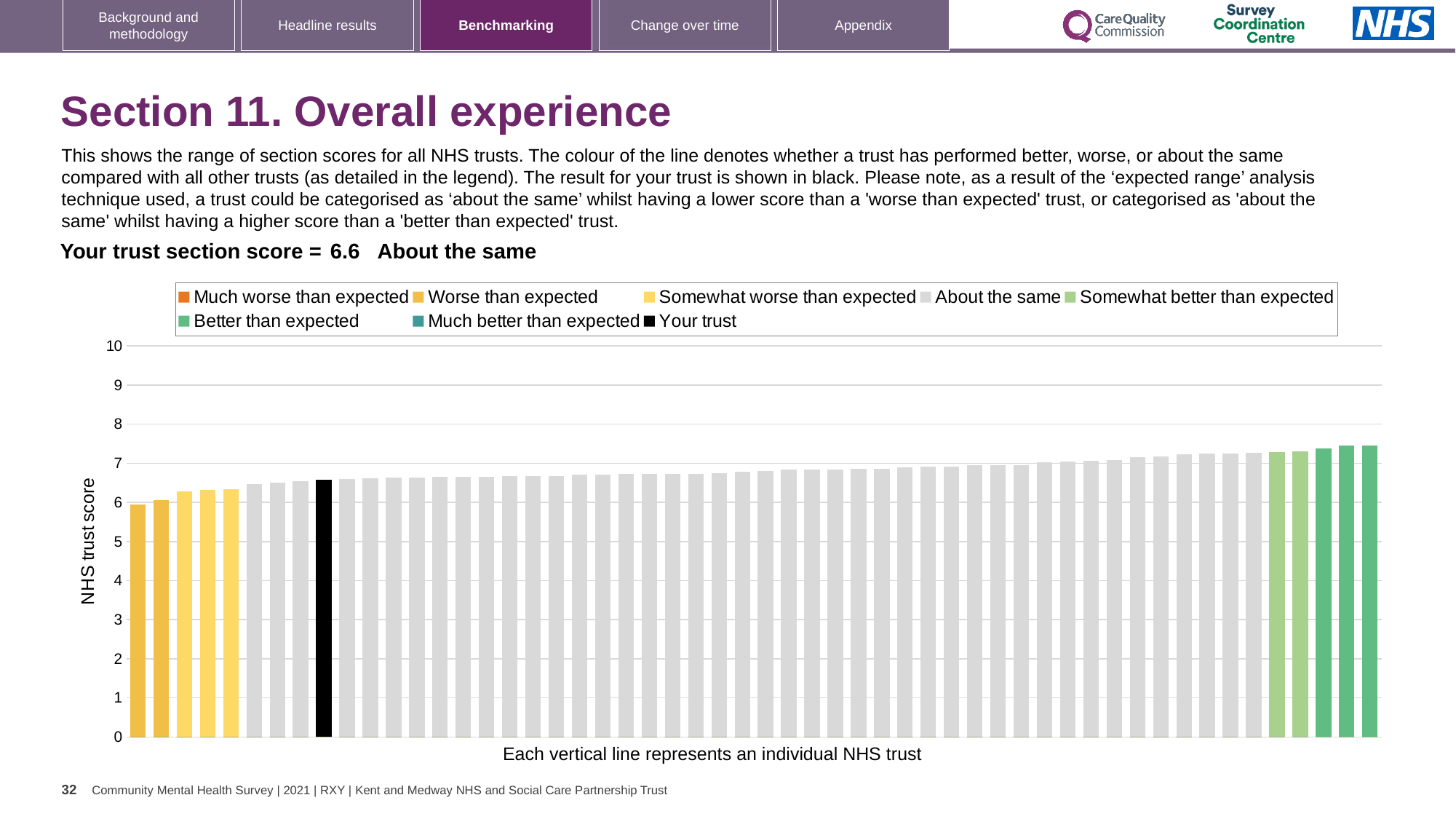
Do the bar values rise or fall from left to right along the x axis? rise How many entries does the chart legend list? 8 What type of chart is shown on the slide? bar chart Is the lowest trust score on the chart greater or less than 7? less Is the highest trust score on the chart greater or less than 7? greater Which benchmarking category is your trust placed in for Section 11? About the same What is the section score for your trust shown on the slide? 6.6 Is the value for your trust greater or less than 6? greater What is the maximum value shown on the vertical axis? 10 What is the label on the vertical axis of the chart? NHS trust score